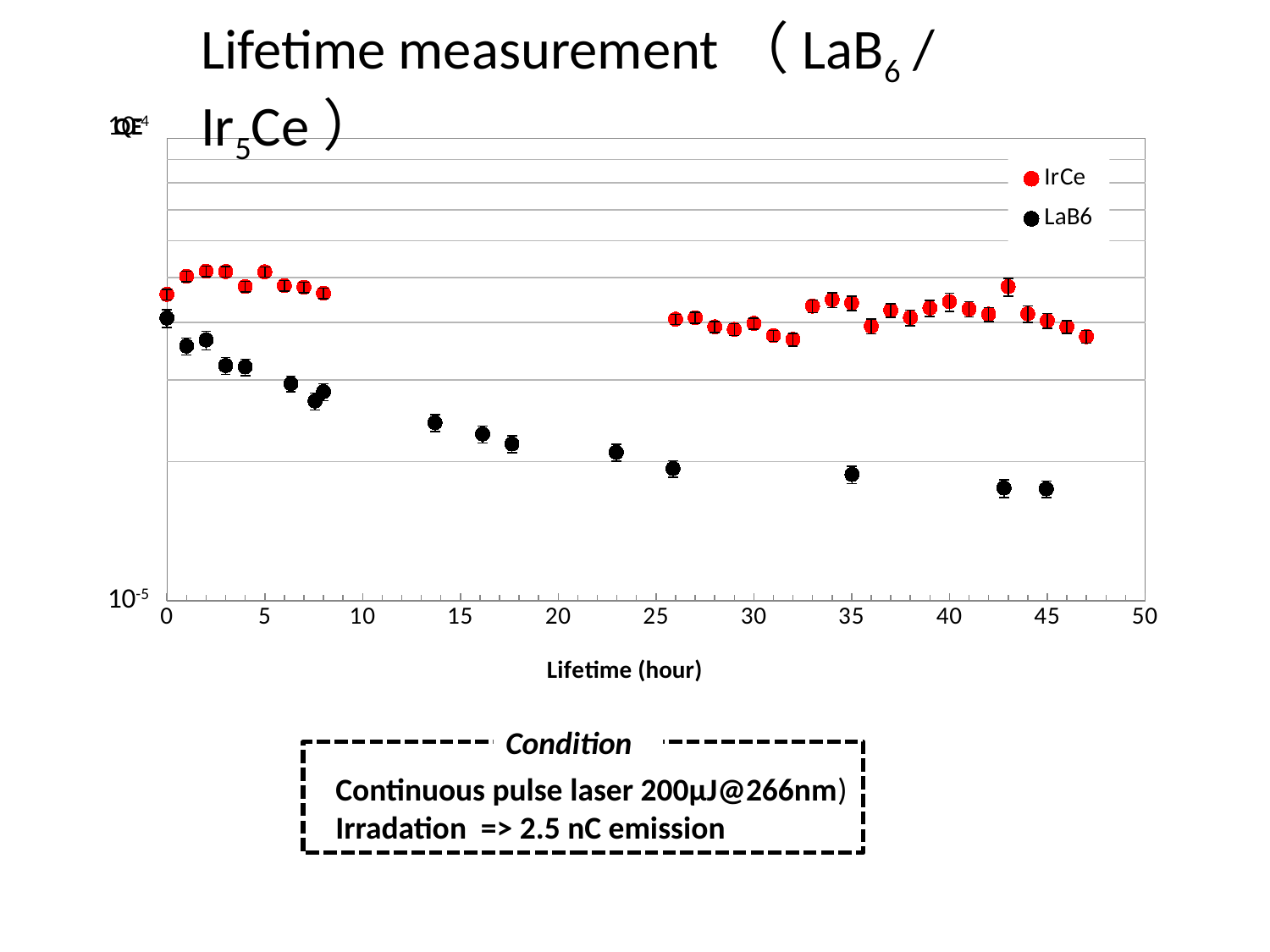
Which series stays roughly constant over the measured lifetime? IrCe Which series has the higher QE at 0 hours, IrCe or LaB6? IrCe Does the LaB6 series rise or fall as lifetime increases from 0 to 45 hours? Fall How many series does the legend list? 2 Which series is plotted with black markers? LaB6 What kind of chart is shown on the slide? Scatter chart What is the maximum value shown on the x axis? 50 Which series reaches the lowest QE value on the chart? LaB6 Is the QE value for LaB6 at 45 hours greater or less than 10^-4? less What are the two series named in the legend? IrCe and LaB6 Which series has the higher QE at 45 hours, IrCe or LaB6? IrCe